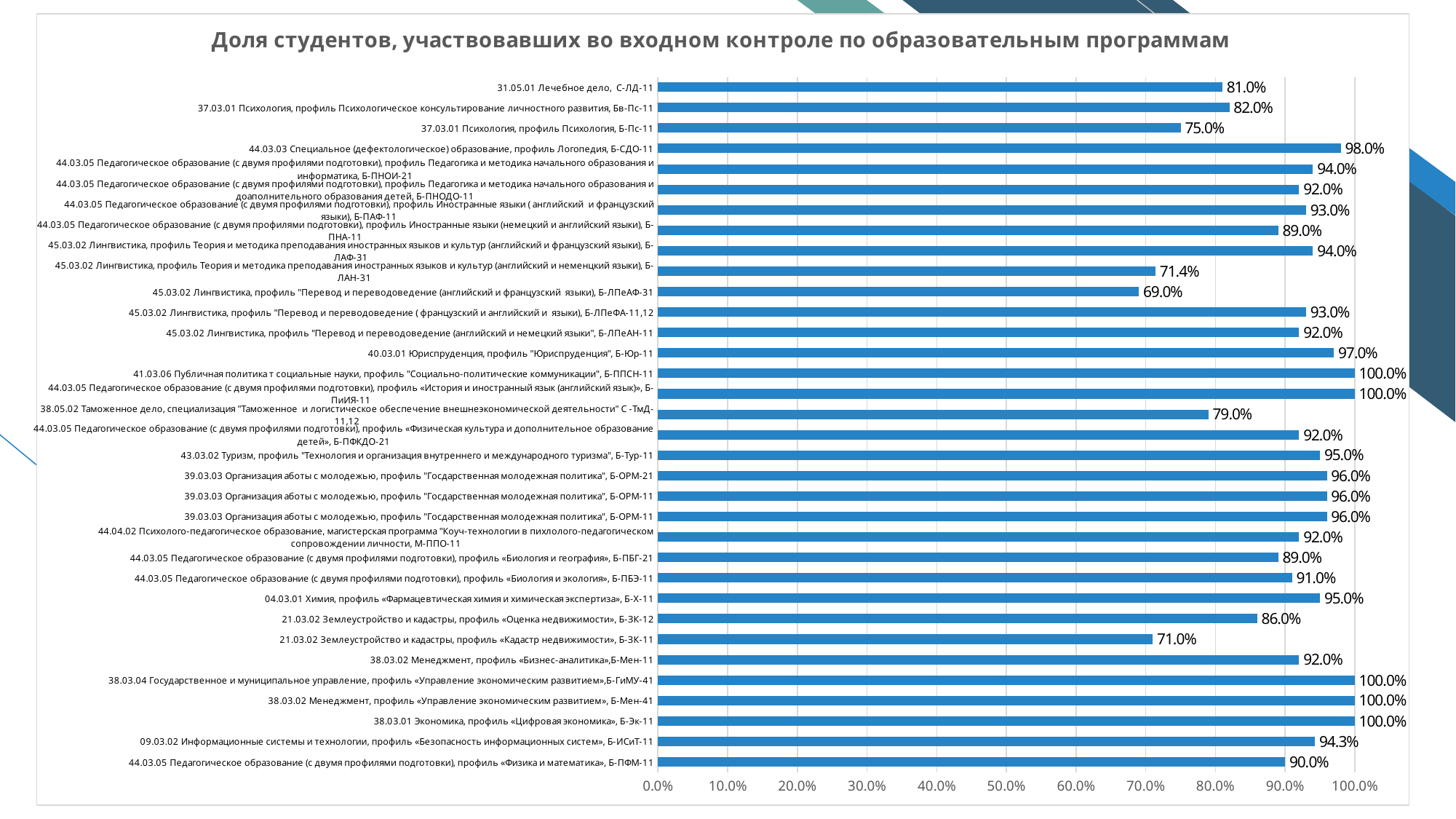
How many educational programmes have a share of 100.0%? 5 What is the value for 09.03.02 Информационные системы и технологии, профиль «Безопасность информационных систем», Б-ИСиТ-11? 94.3% What type of chart is shown on the slide? bar chart What is the difference between the values for 44.03.03 Специальное (дефектологическое) образование, профиль Логопедия, Б-СДО-11 and 37.03.01 Психология, профиль Психология, Б-Пс-11? 23.0% Is the value for 21.03.02 Землеустройство и кадастры, профиль «Кадастр недвижимости», Б-ЗК-11 greater or less than 80.0%? less How many educational programmes are shown in the chart? 34 What is the title of the chart? Доля студентов, участвовавших во входном контроле по образовательным программам Which educational programme has the lowest share? 45.03.02 Лингвистика, профиль "Перевод и переводоведение (английский и французский языки), Б-ЛПеАФ-31 What is the value for 21.03.02 Землеустройство и кадастры, профиль «Оценка недвижимости», Б-ЗК-12? 86.0% What is the value for 31.05.01 Лечебное дело, С-ЛД-11? 81.0% Which has a larger value: 38.05.02 Таможенное дело, С-ТмД-11,12 or 43.03.02 Туризм, Б-Тур-11? 43.03.02 Туризм, Б-Тур-11 What is the value for 45.03.02 Лингвистика, профиль Теория и методика преподавания иностранных языков и культур (английский и неменцкий языки), Б-ЛАН-31? 71.4%